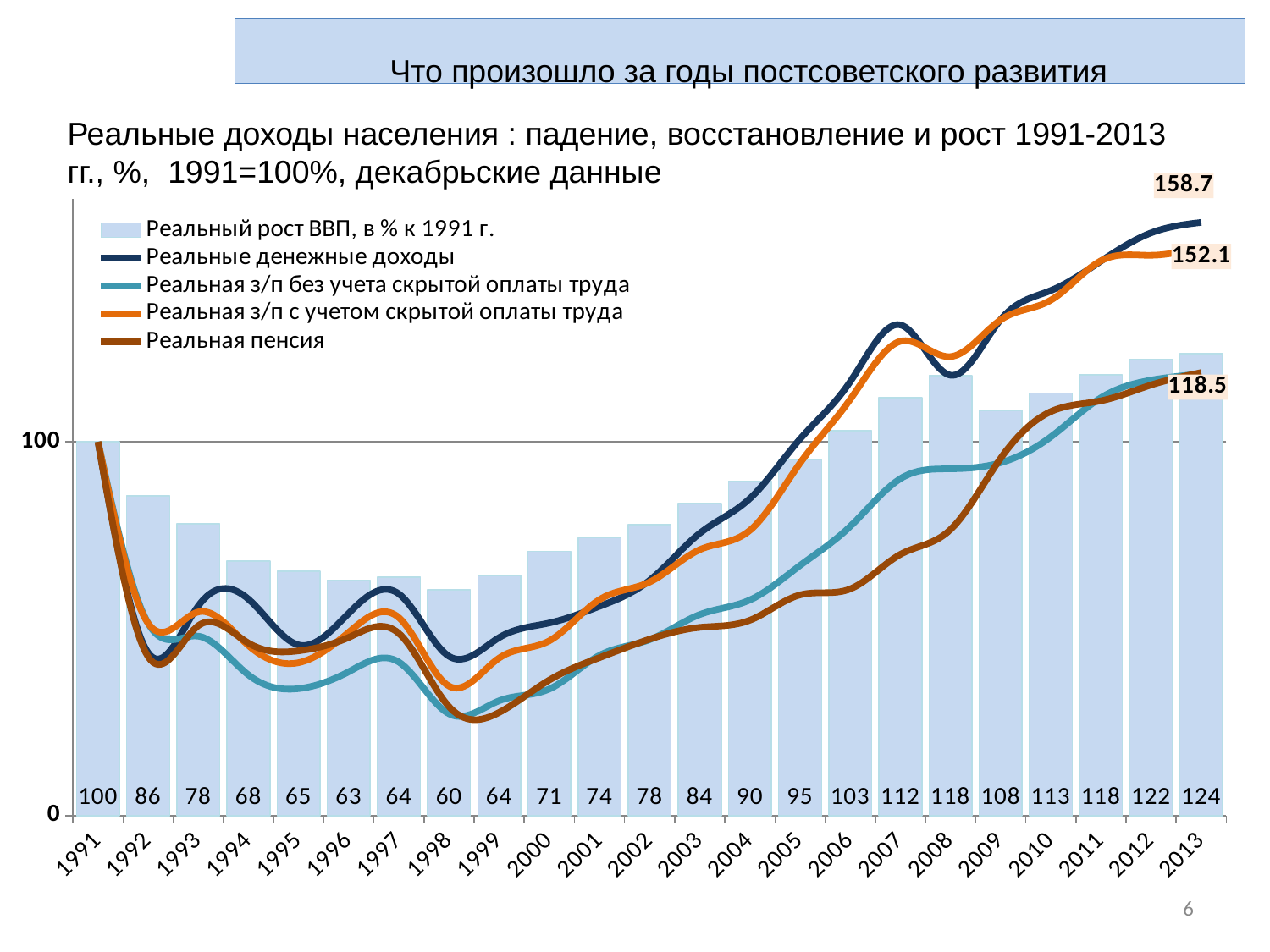
How many series does the legend list? 5 Which year has the lowest real GDP growth bar? 1998 What is the difference between the real GDP growth bars for 2013 and 1991? 24 What value is labelled at the end of the 'Реальная з/п с учетом скрытой оплаты труда' line in 2013? 152.1 Do the real GDP growth bars rise or fall from 1991 to 1998? Fall How many years are shown on the x axis of the chart? 23 What is the value of the real GDP growth bar for 1998? 60 What is the value of the real GDP growth bar for 2013? 124 What value is labelled at the end of the 'Реальная пенсия' line in 2013? 118.5 Which year has the larger real GDP growth bar, 2007 or 2008? 2008 Which year has the highest real GDP growth bar? 2013 What kind of chart is shown on the slide? Combined bar and line chart